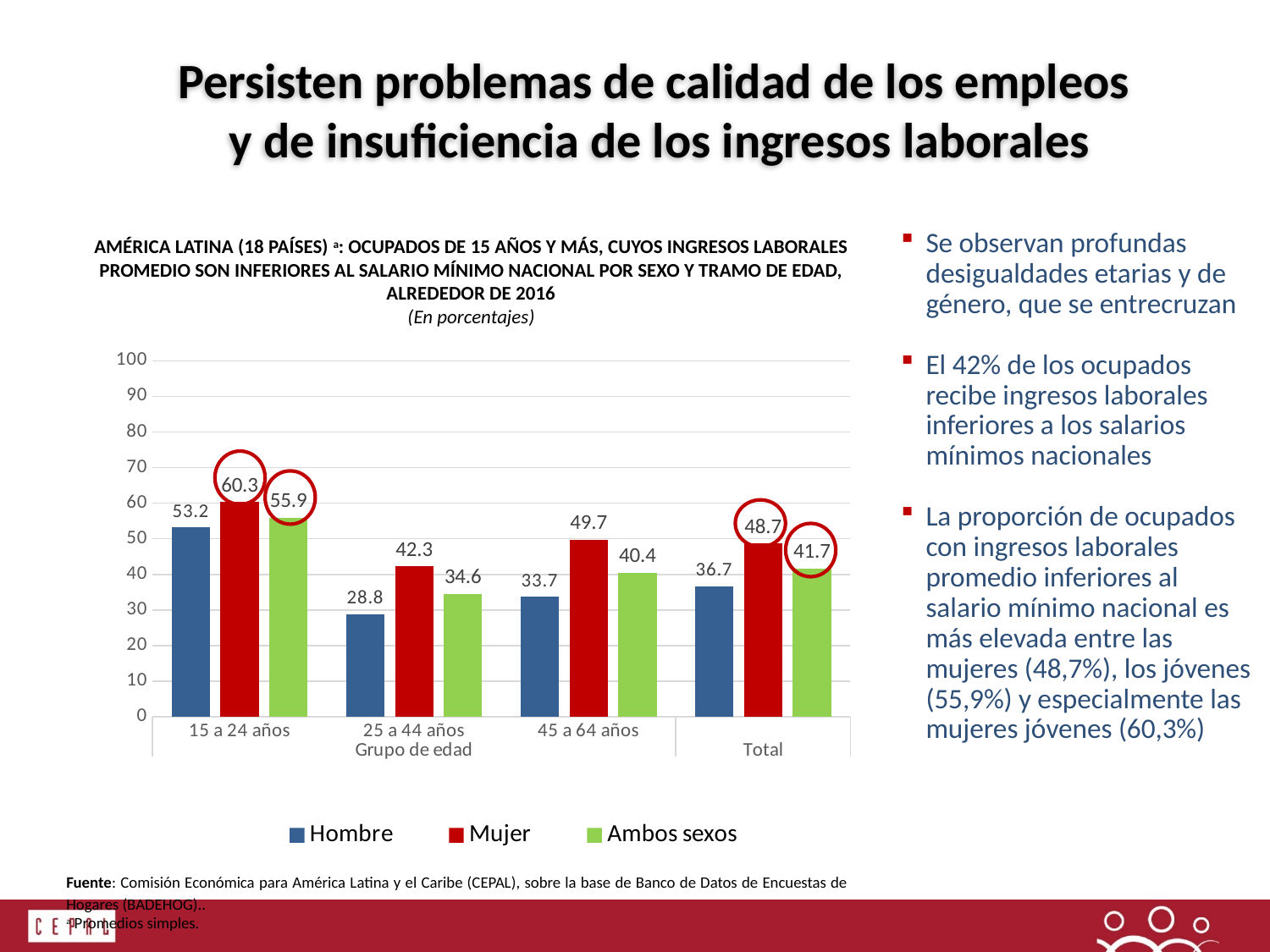
How many age-group categories are shown on the x axis? 3 Which is larger in the Total group, the value for Mujer or the value for Hombre? Mujer What is the value for Mujer in the 15 a 24 años group? 60.3 How many series does the legend list? 3 Which age group has the highest value for Mujer? 15 a 24 años What is the value for Hombre in the 25 a 44 años group? 28.8 Which age group has the lowest value for Hombre? 25 a 44 años What is the value for Ambos sexos in the Total group? 41.7 Which colour represents the Mujer series in the chart? Red Is the value for Ambos sexos in the 25 a 44 años group greater or less than 40? less What is the difference between the Mujer and Hombre values in the 45 a 64 años group? 16.0 What kind of chart is shown on the slide? Bar chart